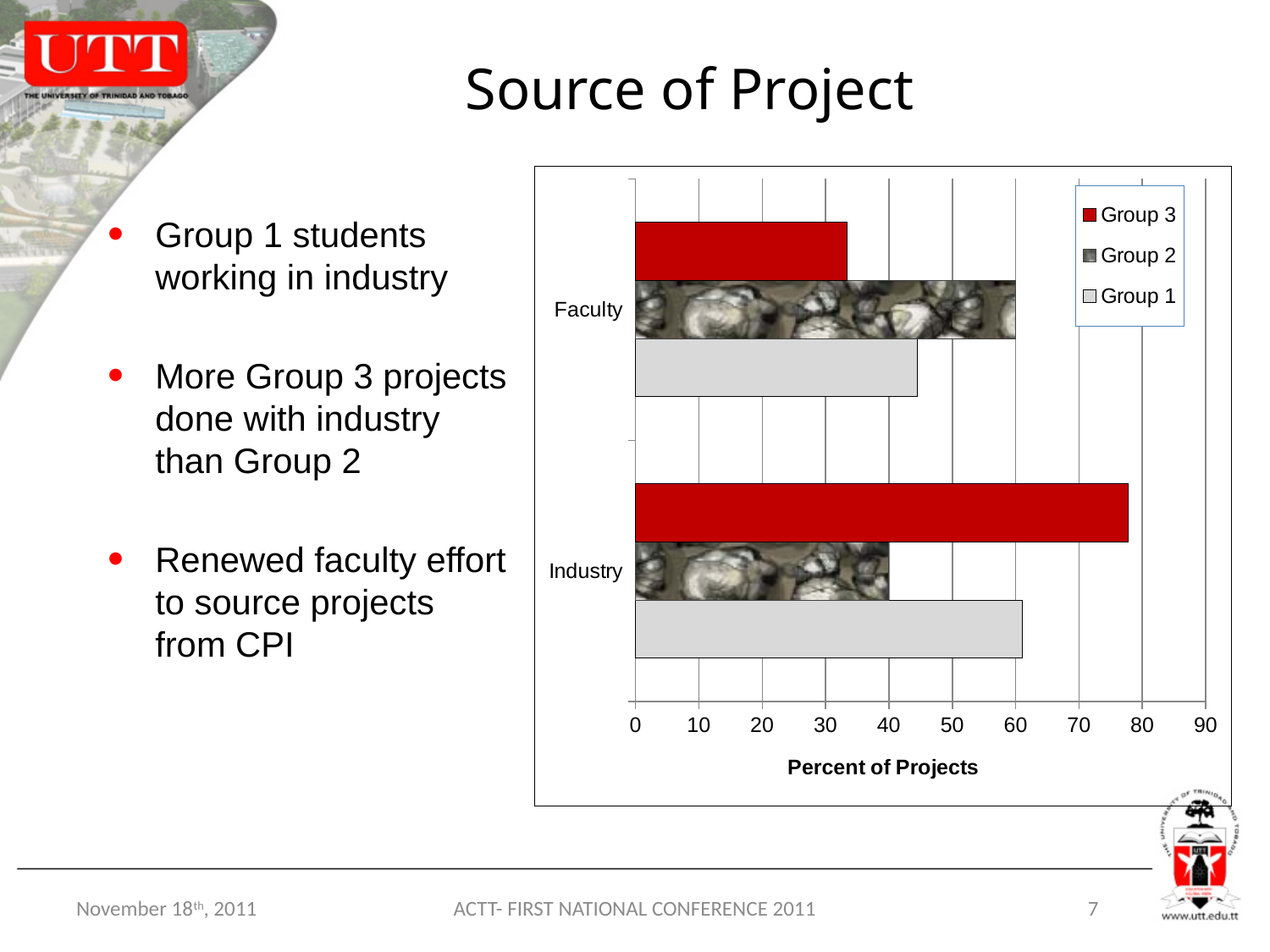
What kind of chart is shown on the slide? bar chart What is the title of the chart's horizontal axis? Percent of Projects Which group has the lowest value in the Faculty category? Group 3 Is the value for Group 1 in the Industry category greater or less than 50? greater Is the value for Group 3 in the Industry category greater or less than 70? greater Is the value for Group 2 in the Industry category greater or less than 50? less How many categories are shown on the chart's vertical axis? 2 Which series is shown in red in the chart's legend? Group 3 For Group 3, which category has the larger value, Faculty or Industry? Industry How many series does the chart's legend list? 3 Which group has the highest value in the Industry category? Group 3